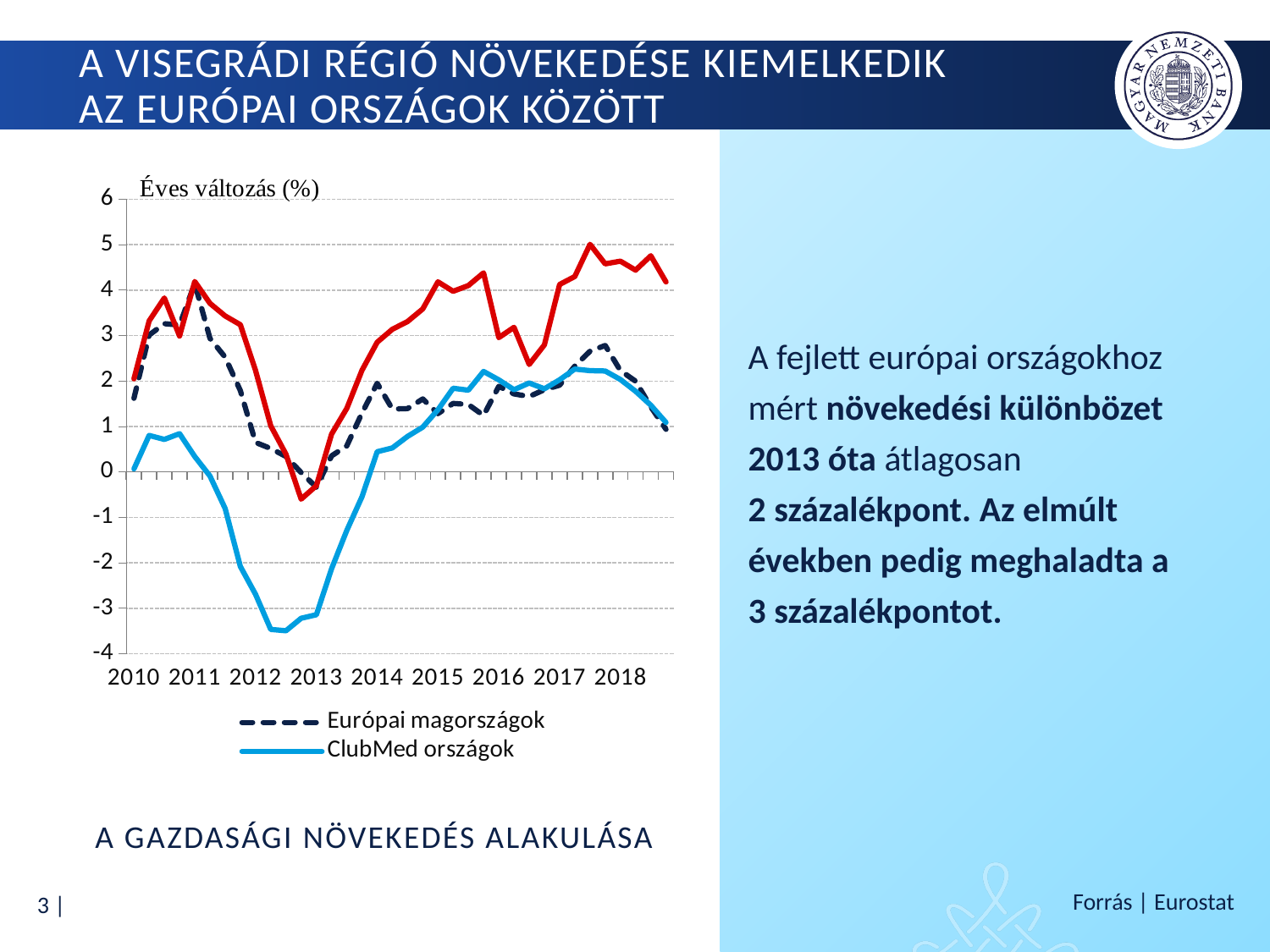
Does the Európai magországok line rise or fall between 2011 and 2013? fall How many series does the chart legend list? 2 How many year labels are shown on the x axis of the chart? 9 What is the label on the y axis of the chart? Éves változás (%) What is the title of the chart? A GAZDASÁGI NÖVEKEDÉS ALAKULÁSA Which series in the legend reaches the lowest value on the chart? ClubMed országok Is the value for ClubMed országok at 2016 greater or less than 1? greater At 2011, which series has the higher value: Európai magországok or ClubMed országok? Európai magországok What kind of chart is shown on the slide? line chart Does the ClubMed országok line rise or fall between 2013 and 2016? rise Is the value for Európai magországok at 2011 greater or less than 2? greater Is the value for ClubMed országok at 2013 greater or less than -2? less